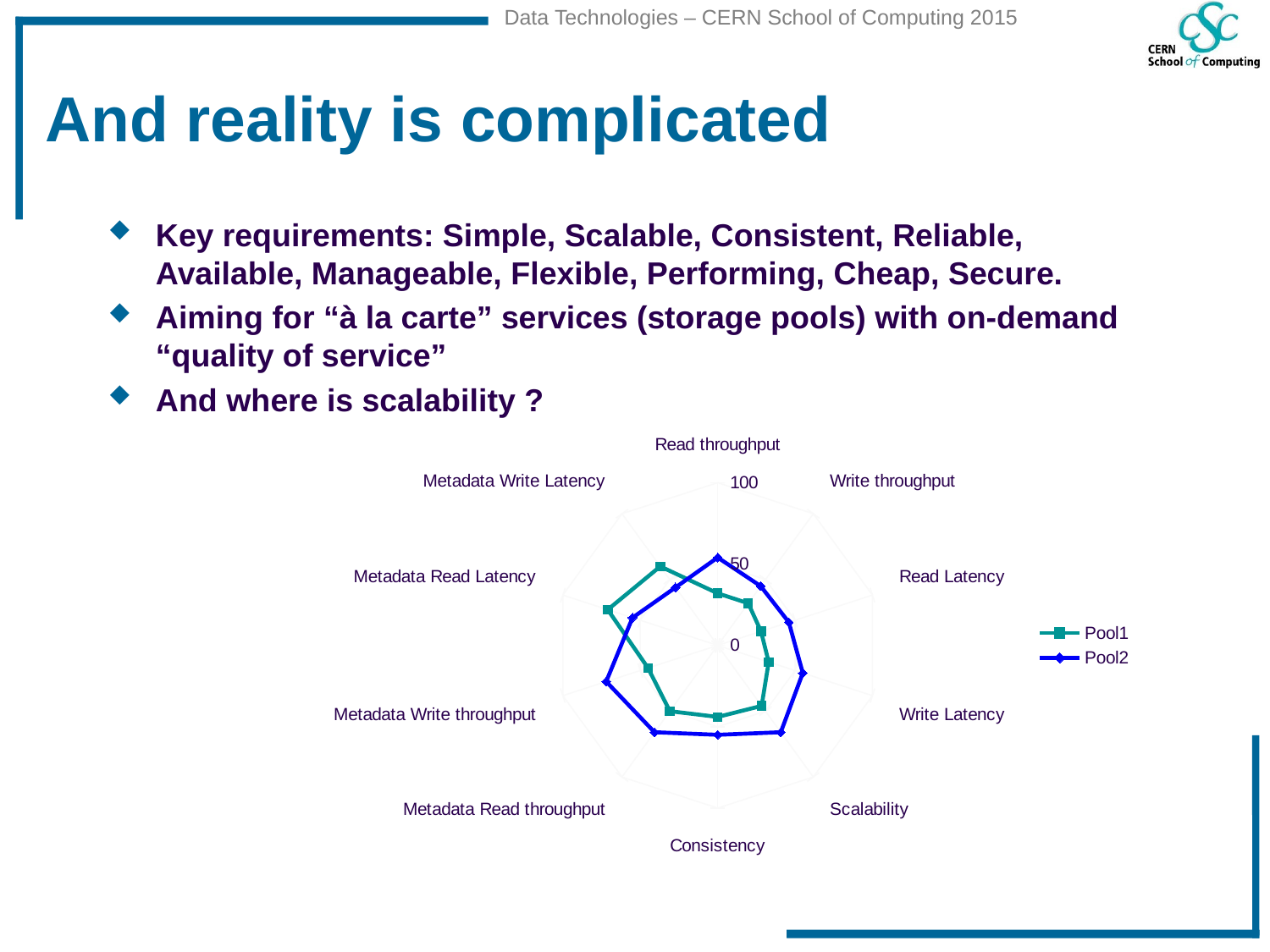
Is the Pool1 value for Metadata Read Latency greater or less than 50? greater Is the Pool1 value for Write Latency greater or less than 50? less How many categories (axes) does the radar chart have? 10 What kind of chart is shown on the slide? Radar chart How many series does the chart's legend list? 2 Is the Pool2 value for Metadata Write throughput greater or less than 50? greater What are the two series named in the chart legend? Pool1 and Pool2 Which series has the larger value for Metadata Read Latency, Pool1 or Pool2? Pool1 On which axis does Pool1 reach its highest value? Metadata Read Latency Which series has the larger value for Read throughput, Pool1 or Pool2? Pool2 Which series has the larger value for Scalability, Pool1 or Pool2? Pool2